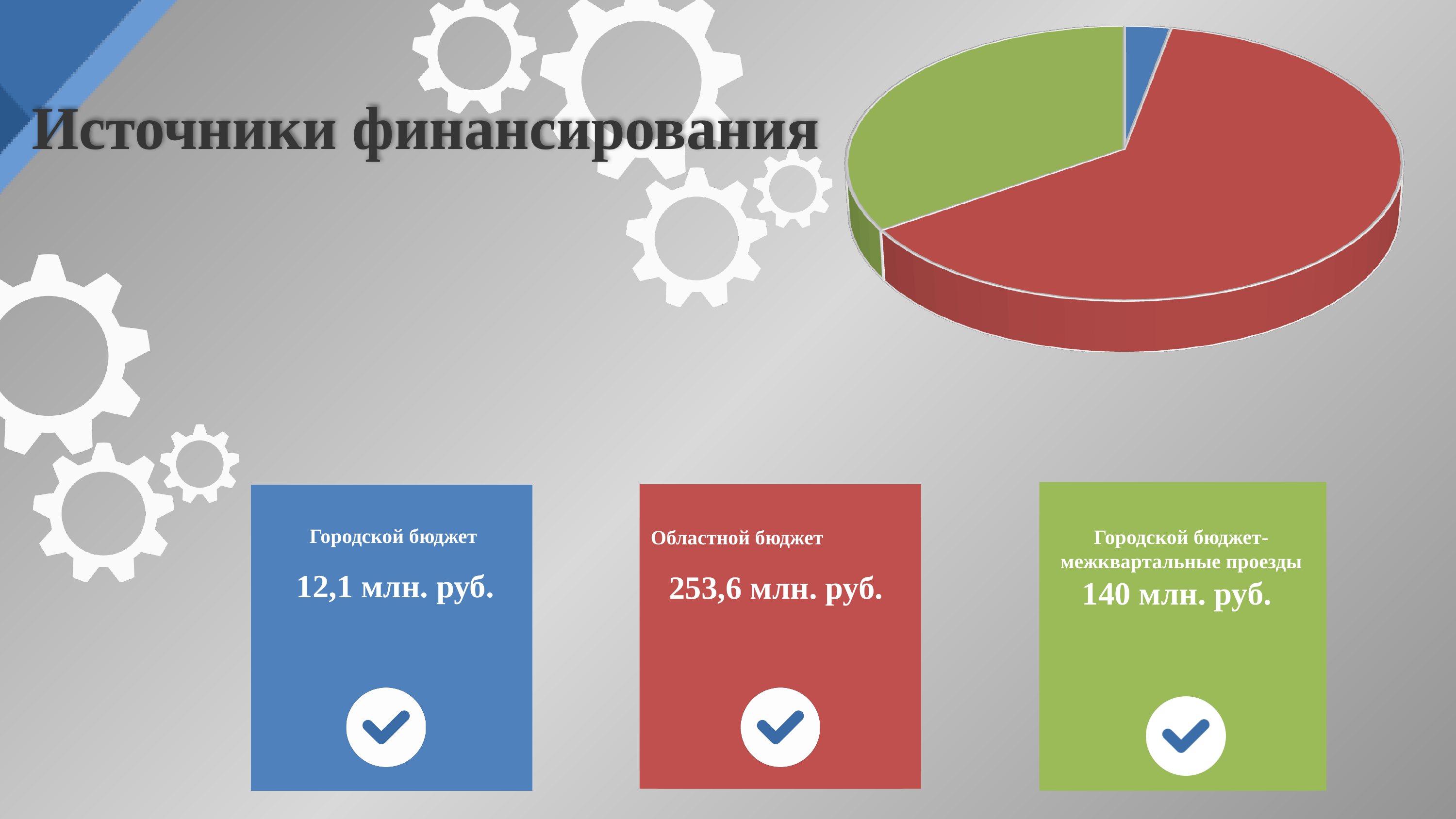
What is the value for Городской бюджет? 12,1 млн. руб. What is the value for Областной бюджет? 253,6 млн. руб. What kind of chart is shown on the slide? Pie chart How many slices does the pie chart have? 3 Which funding source has the smallest slice of the pie? Городской бюджет Which is larger, Областной бюджет or Городской бюджет-межквартальные проезды? Областной бюджет What is the value for Городской бюджет-межквартальные проезды? 140 млн. руб. What colour is the slice for Областной бюджет in the pie chart? Red Which funding source has the largest slice of the pie? Областной бюджет What is the difference between Областной бюджет and Городской бюджет? 241,5 млн. руб. What is the difference between Областной бюджет and Городской бюджет-межквартальные проезды? 113,6 млн. руб. What is the title of the slide with the pie chart? Источники финансирования